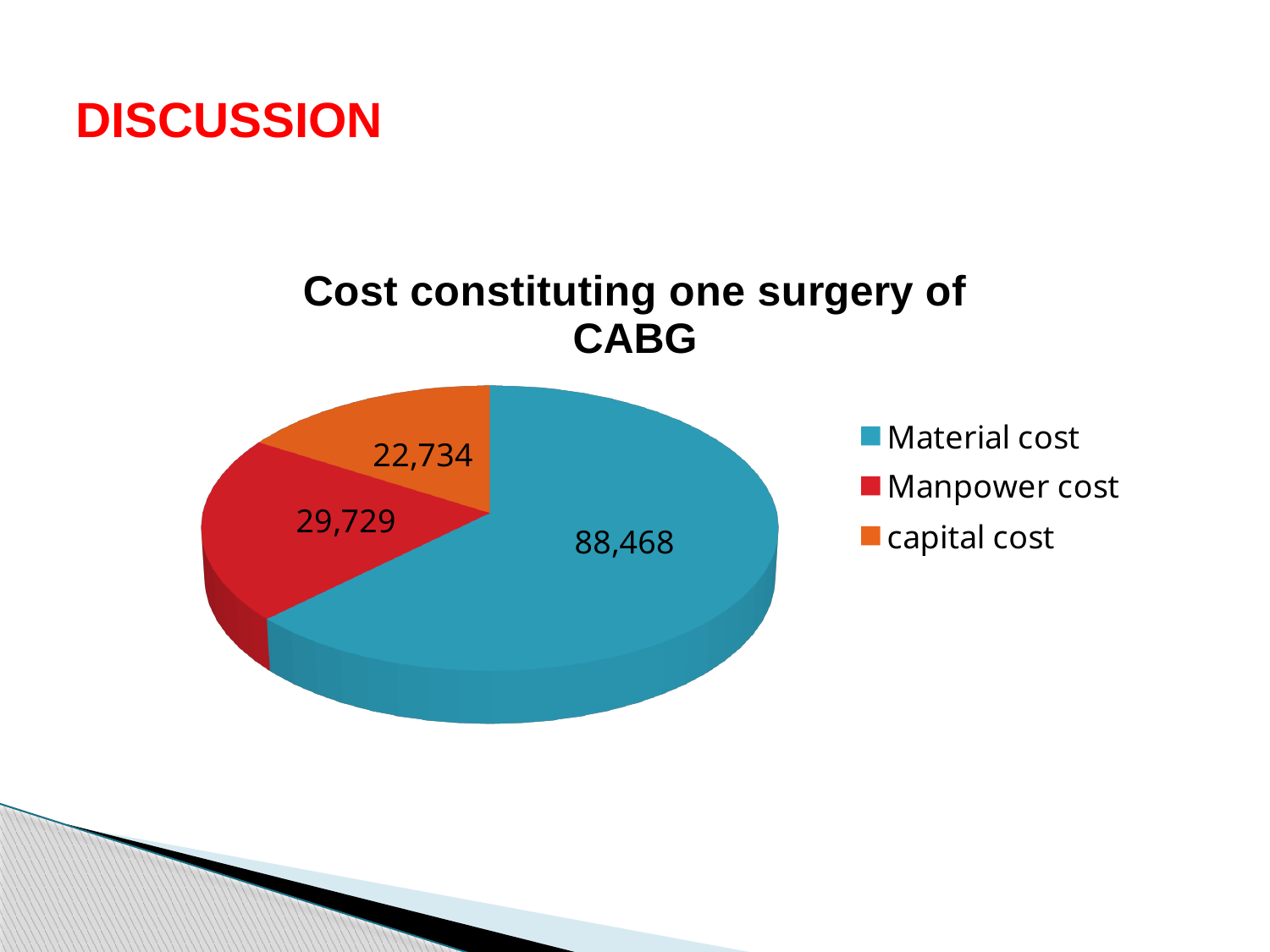
What is the total of all three cost categories shown in the pie chart? 140,931 What type of chart is shown on the slide? Pie chart What is the difference between Manpower cost and capital cost? 6,995 What is the value shown for capital cost? 22,734 Which cost category has the largest slice of the pie? Material cost Which cost category has the smallest slice of the pie? capital cost Which is larger, Manpower cost or capital cost? Manpower cost What is the value shown for Material cost? 88,468 What is the title of the chart? Cost constituting one surgery of CABG What is the value shown for Manpower cost? 29,729 How many categories does the pie chart show? 3 What is the difference between Material cost and Manpower cost? 58,739